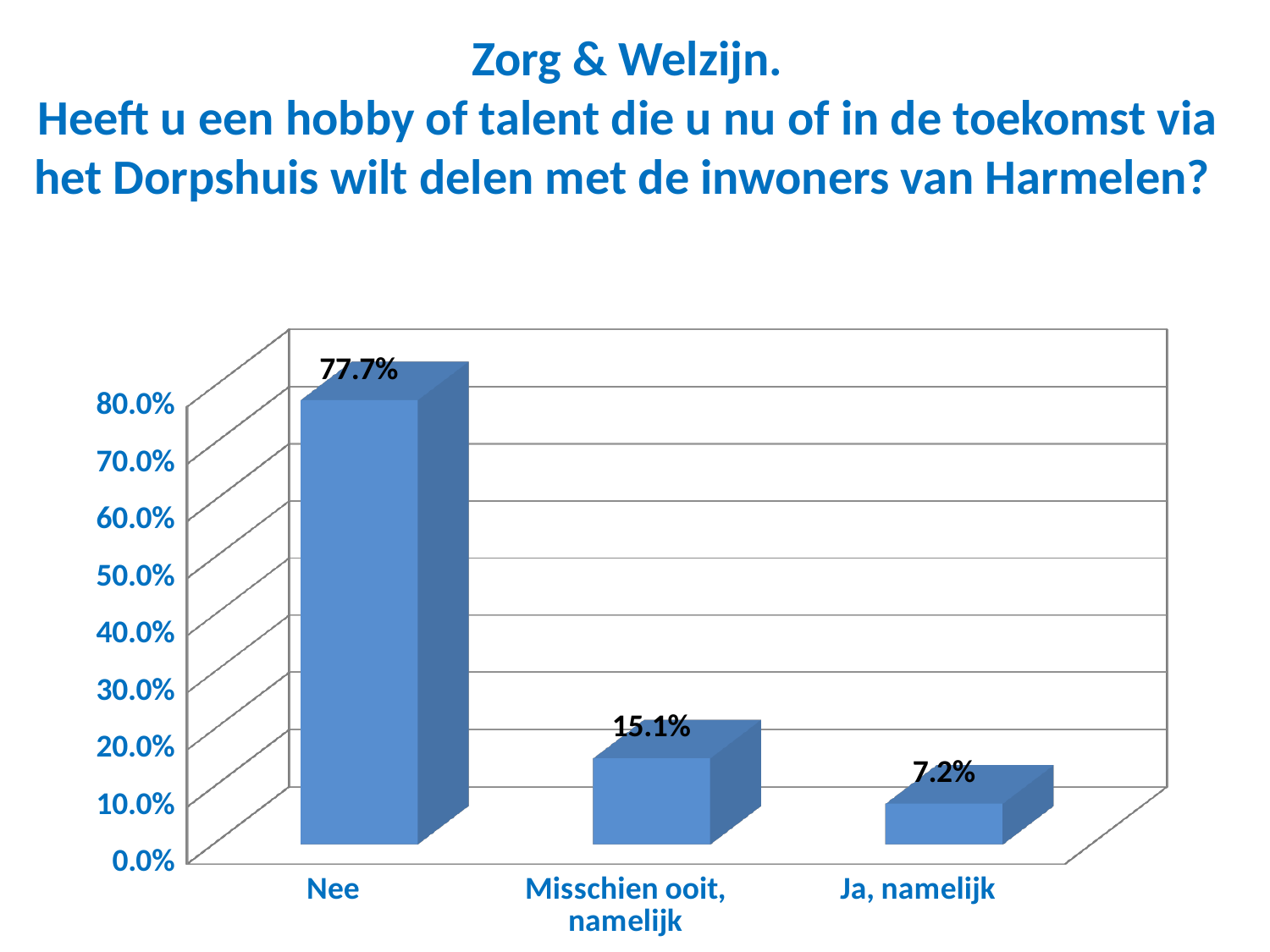
What is the value for "Ja, namelijk"? 7.2% What is the difference between the values for "Nee" and "Misschien ooit, namelijk"? 62.6% What kind of chart is shown on the slide? Bar chart Which is larger, the value for "Misschien ooit, namelijk" or the value for "Ja, namelijk"? Misschien ooit, namelijk Is the value for "Nee" greater or less than 70.0%? greater How many categories are shown on the x axis? 3 Do the values rise or fall from left to right along the x axis? Fall What is the value for "Nee"? 77.7% Which category has the highest value? Nee What is the difference between the values for "Misschien ooit, namelijk" and "Ja, namelijk"? 7.9% Which category has the lowest value? Ja, namelijk What is the value for "Misschien ooit, namelijk"? 15.1%